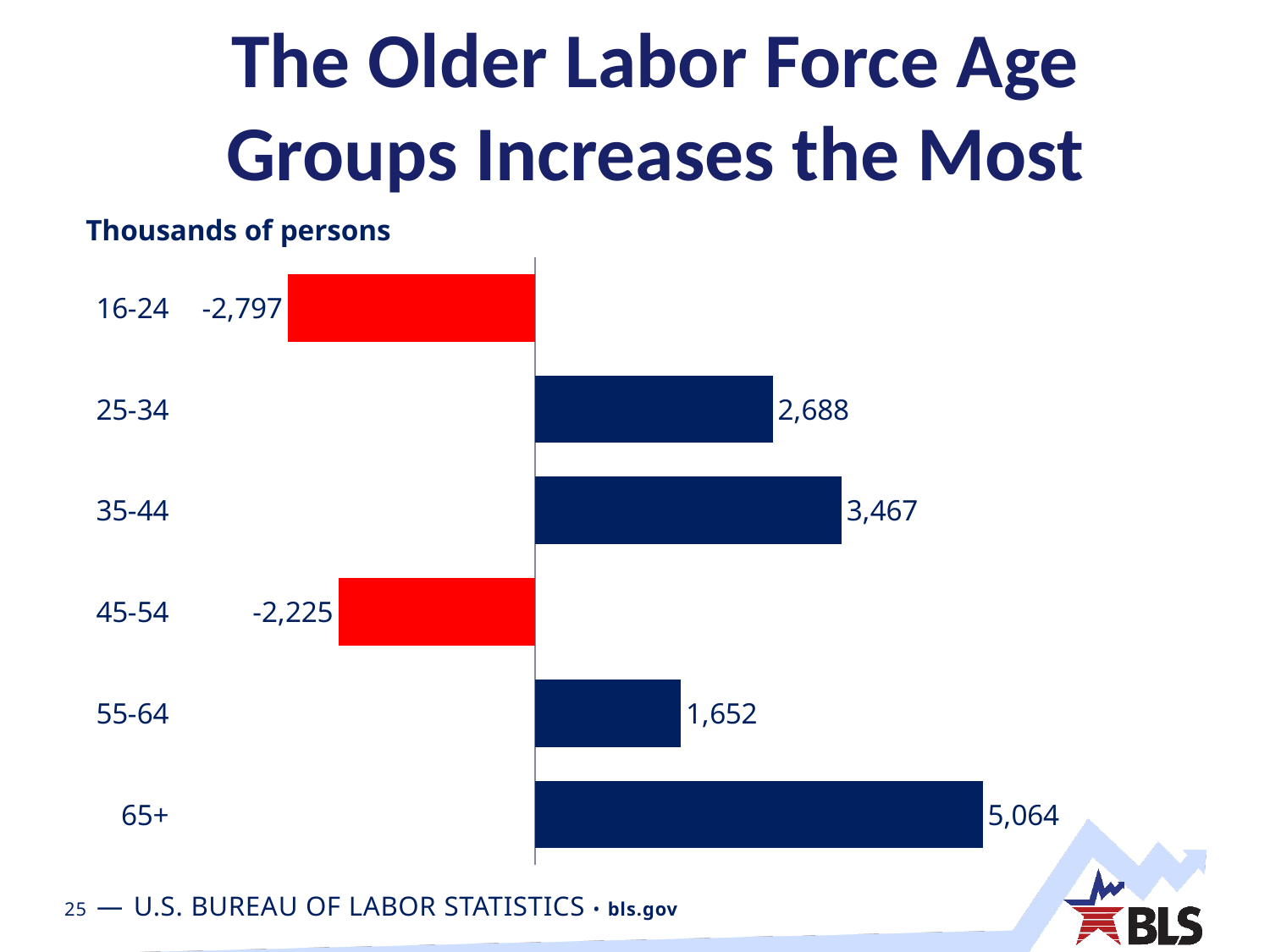
What is the difference between the values for 65+ and 55-64? 3,412 Which age group has the highest value? 65+ What is the value for the 45-54 age group? -2,225 What kind of chart is shown on the slide? Bar chart Which age group has the lowest value? 16-24 What is the value for the 35-44 age group? 3,467 How many age groups are shown in the chart? 6 What unit is stated above the chart? Thousands of persons What is the value for the 16-24 age group? -2,797 Which is larger, the value for 25-34 or the value for 55-64? 25-34 What is the value for the 65+ age group? 5,064 What is the difference between the values for 35-44 and 25-34? 779